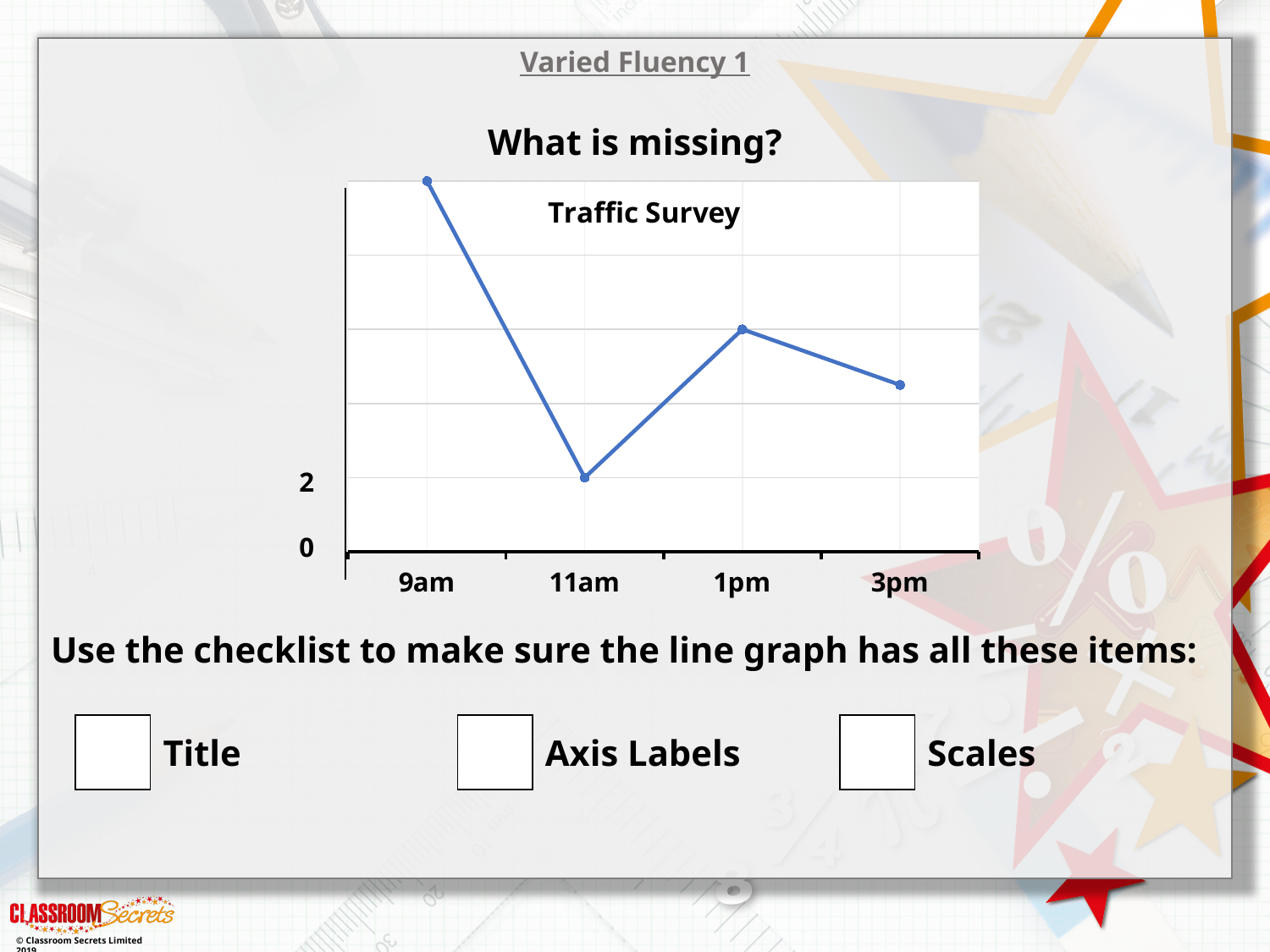
What kind of chart is shown on the slide? line chart What is the value at 11am? 2 Is the value at 3pm greater or less than 2? greater At which time is the value highest? 9am Which is larger, the value at 9am or the value at 1pm? 9am What is the title of the chart? Traffic Survey At which time is the value lowest? 11am Which is larger, the value at 1pm or the value at 3pm? 1pm Does the line rise or fall from 11am to 1pm? rise Does the line rise or fall from 9am to 11am? fall Is the value at 9am greater or less than 2? greater How many data points are plotted on the line? 4